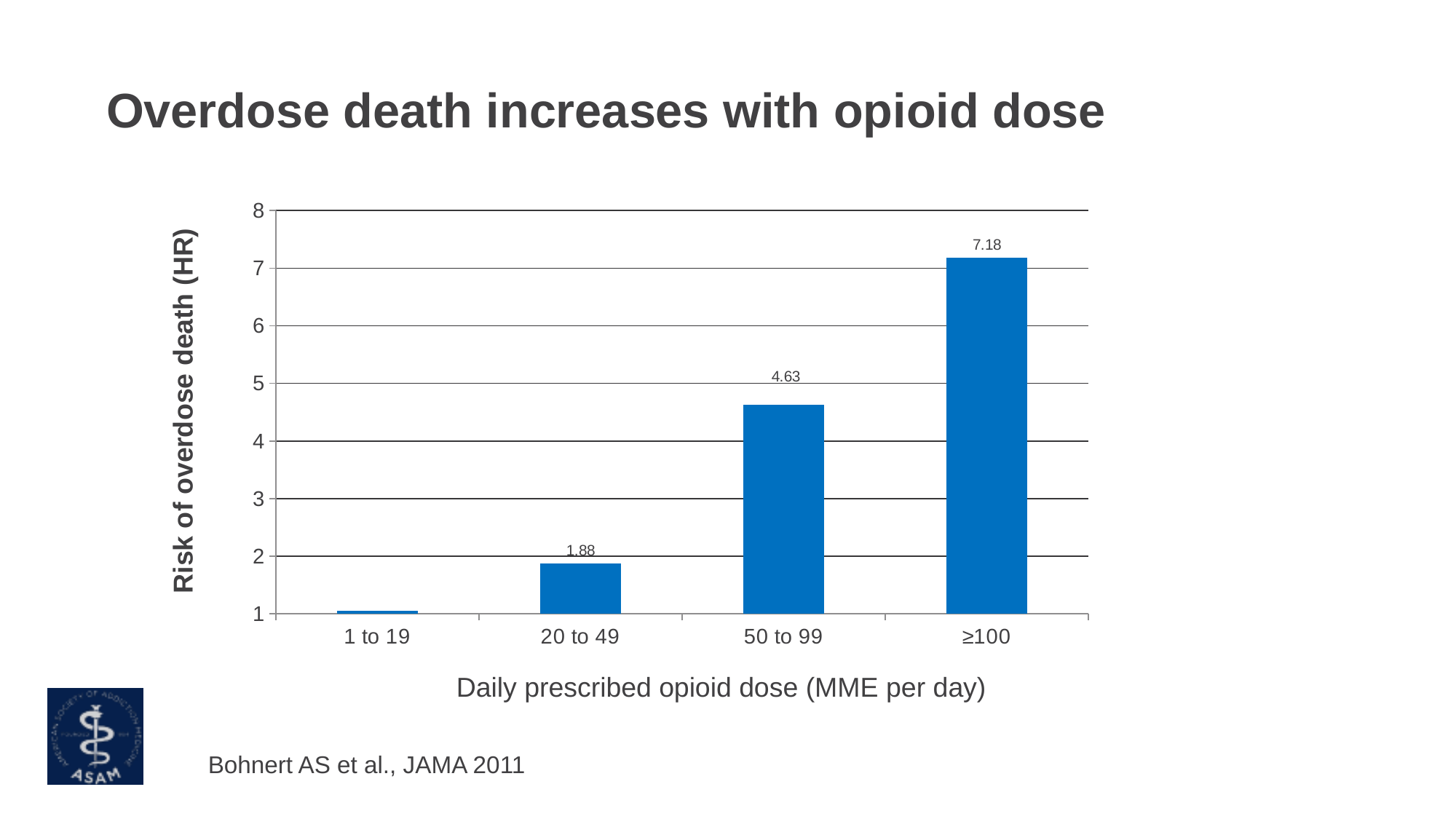
What is the difference in risk of overdose death (HR) between the 50 to 99 group and the 20 to 49 group? 2.75 Which daily opioid dose group has the lowest risk of overdose death? 1 to 19 Which daily opioid dose group has the highest risk of overdose death? ≥100 Does the risk of overdose death rise or fall as the daily prescribed opioid dose increases along the x axis? Rises How many daily opioid dose groups are shown on the chart? 4 What is the risk of overdose death (HR) for the 50 to 99 MME per day dose group? 4.63 What is the risk of overdose death (HR) for the ≥100 MME per day dose group? 7.18 What kind of chart is shown on the slide? Bar chart What is the difference in risk of overdose death (HR) between the ≥100 group and the 50 to 99 group? 2.55 Which has a higher risk of overdose death: the 20 to 49 group or the 50 to 99 group? 50 to 99 What is the risk of overdose death (HR) for the 20 to 49 MME per day dose group? 1.88 Is the risk of overdose death for the 1 to 19 group greater or less than 2? less